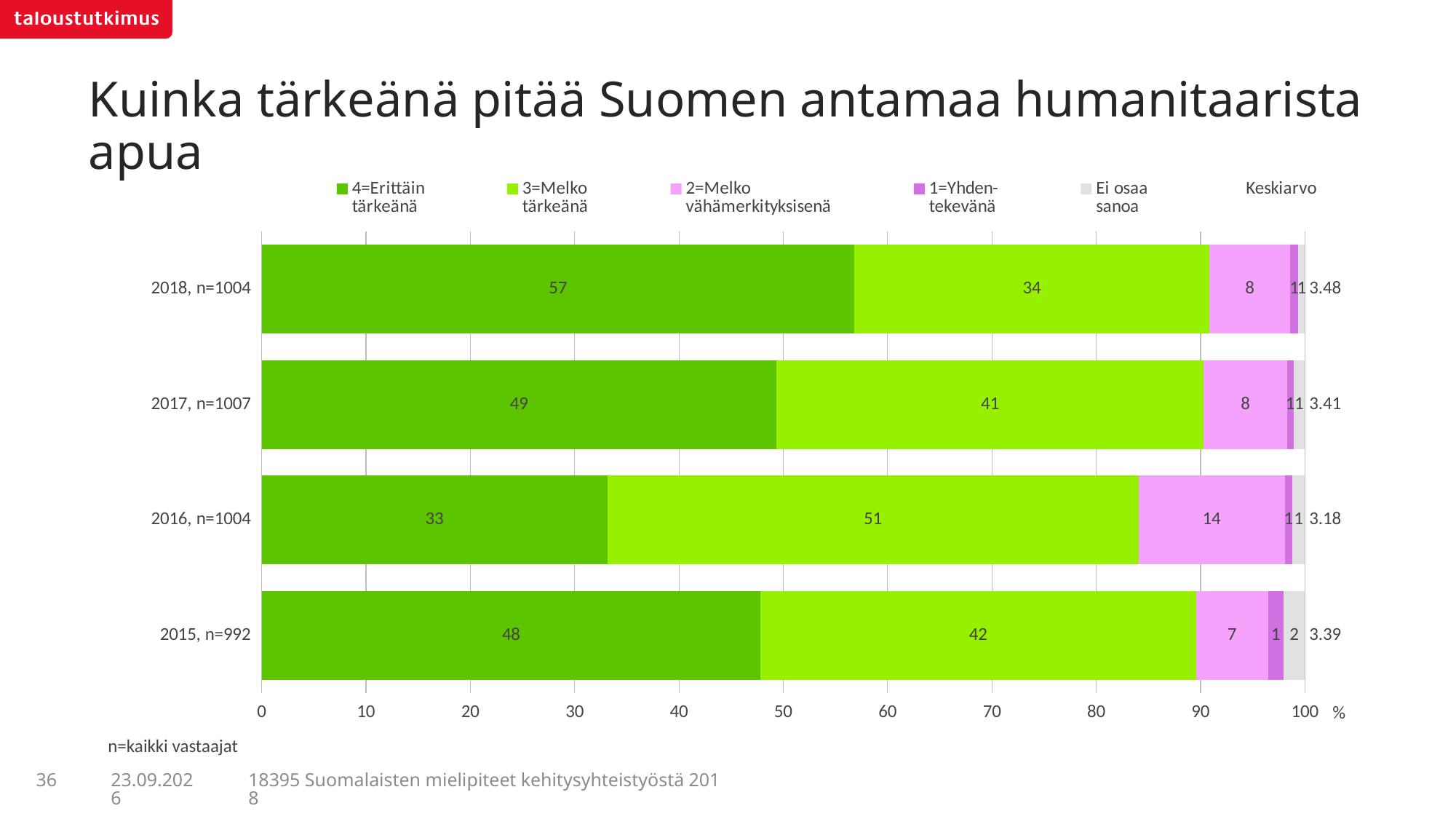
What is the difference between the 4=Erittäin tärkeänä values for 2018 and 2017? 8 What is the value for Ei osaa sanoa in 2015 (n=992)? 2 What is the value for 2=Melko vähämerkityksisenä in 2016 (n=1004)? 14 Which year has the lowest Keskiarvo? 2016, n=1004 Which year has the larger 3=Melko tärkeänä value, 2016 or 2015? 2016, n=1004 How many years (categories) are shown in the chart? 4 Which year has the highest share of 4=Erittäin tärkeänä? 2018, n=1004 What percentage of respondents in 2018 (n=1004) rated Finland's humanitarian aid as 4=Erittäin tärkeänä? 57 What type of chart is shown on the slide? Stacked bar chart How many coloured series does the legend list? 5 What is the Keskiarvo (mean) shown for 2015 (n=992)? 3.39 What is the value for 3=Melko tärkeänä in 2016 (n=1004)? 51